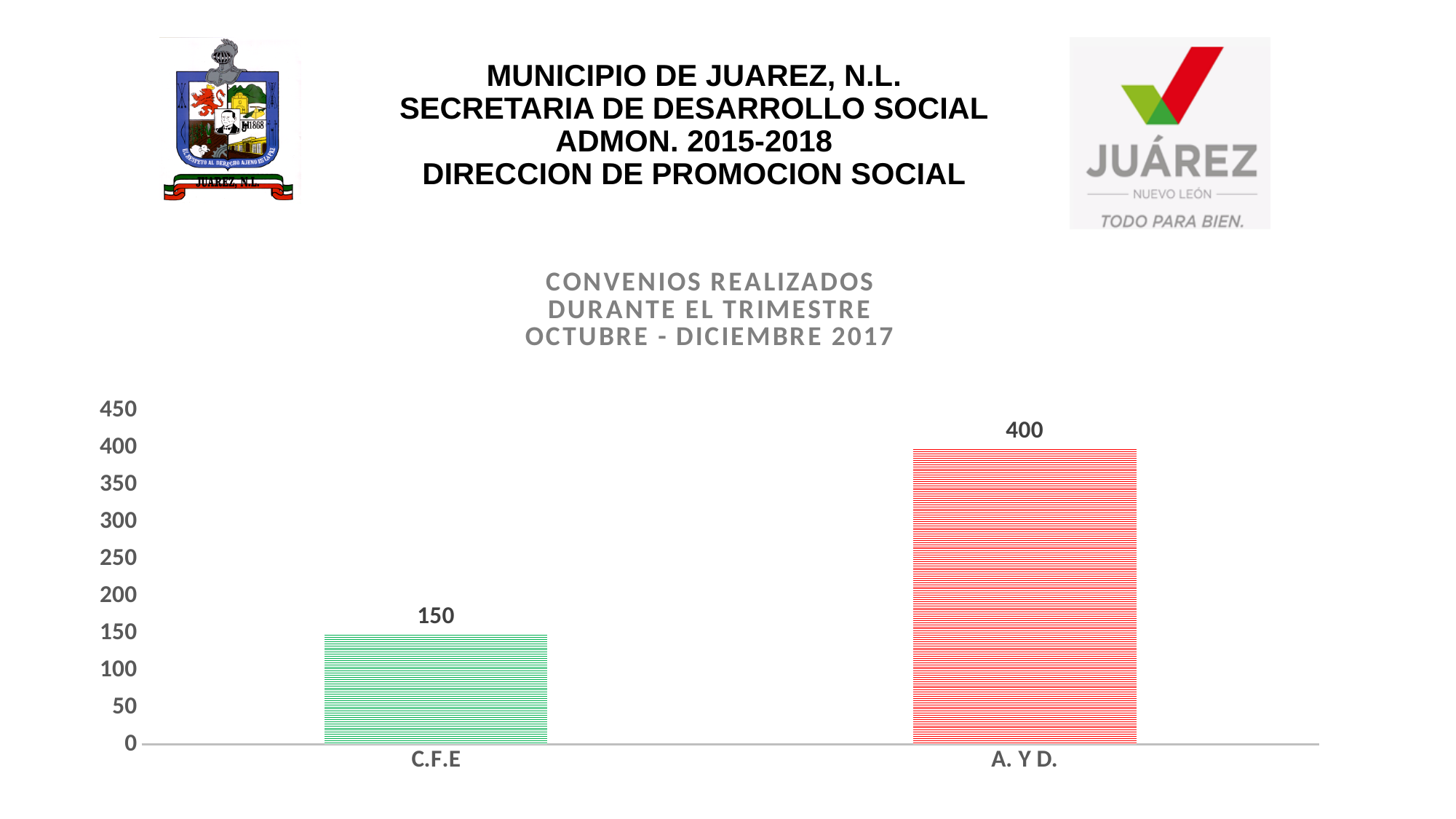
What is the difference between the values for A. Y D. and C.F.E? 250 What colour is the bar for A. Y D.? red What is the value for A. Y D.? 400 Which category has the highest value? A. Y D. How many categories are shown on the chart? 2 What kind of chart is shown on the slide? bar chart What is the value for C.F.E? 150 Is the value for C.F.E greater or less than 200? less Is the value for A. Y D. greater or less than 300? greater Which is larger, the value for C.F.E or the value for A. Y D.? A. Y D. Which category has the lowest value? C.F.E What is the title of the chart? CONVENIOS REALIZADOS DURANTE EL TRIMESTRE OCTUBRE - DICIEMBRE 2017